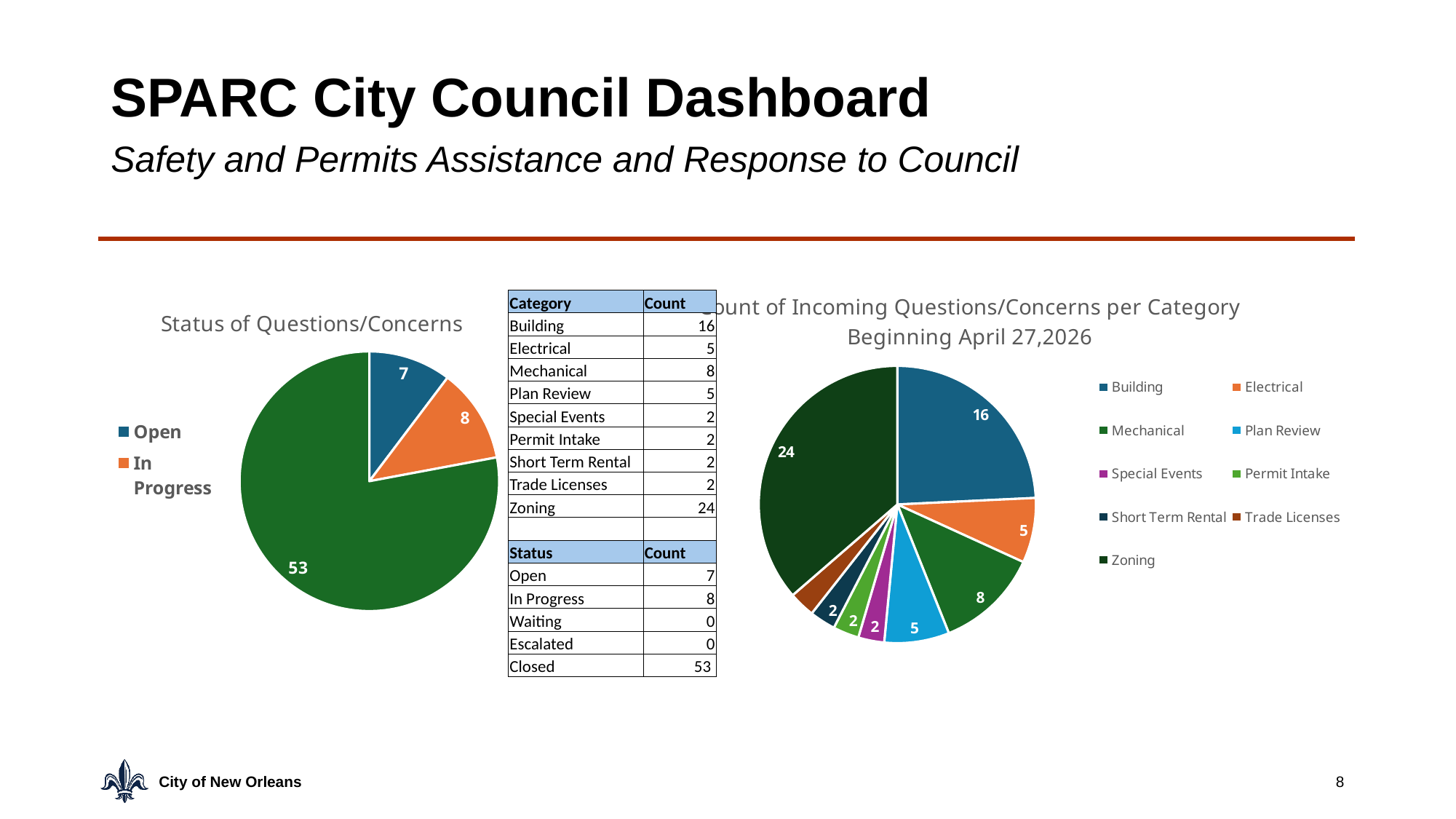
In the 'Count of Incoming Questions/Concerns per Category' pie chart, what is the value for Building? 16 In the 'Count of Incoming Questions/Concerns per Category' pie chart, which is larger, Electrical or Mechanical? Mechanical What type of chart is 'Status of Questions/Concerns'? Pie chart In the 'Status of Questions/Concerns' pie chart, which is larger, Open or In Progress? In Progress How many categories does the legend of the 'Count of Incoming Questions/Concerns per Category' pie chart list? 9 In the 'Count of Incoming Questions/Concerns per Category' pie chart, what is the value for Mechanical? 8 In the 'Status of Questions/Concerns' pie chart, what is the value for In Progress? 8 In the 'Count of Incoming Questions/Concerns per Category' pie chart, what is the value for Zoning? 24 In the 'Status of Questions/Concerns' pie chart, what is the value for Open? 7 In the 'Count of Incoming Questions/Concerns per Category' pie chart, what is the difference between the Zoning and Building values? 8 What type of chart is 'Count of Incoming Questions/Concerns per Category'? Pie chart In the 'Count of Incoming Questions/Concerns per Category' pie chart, which category has the largest slice? Zoning